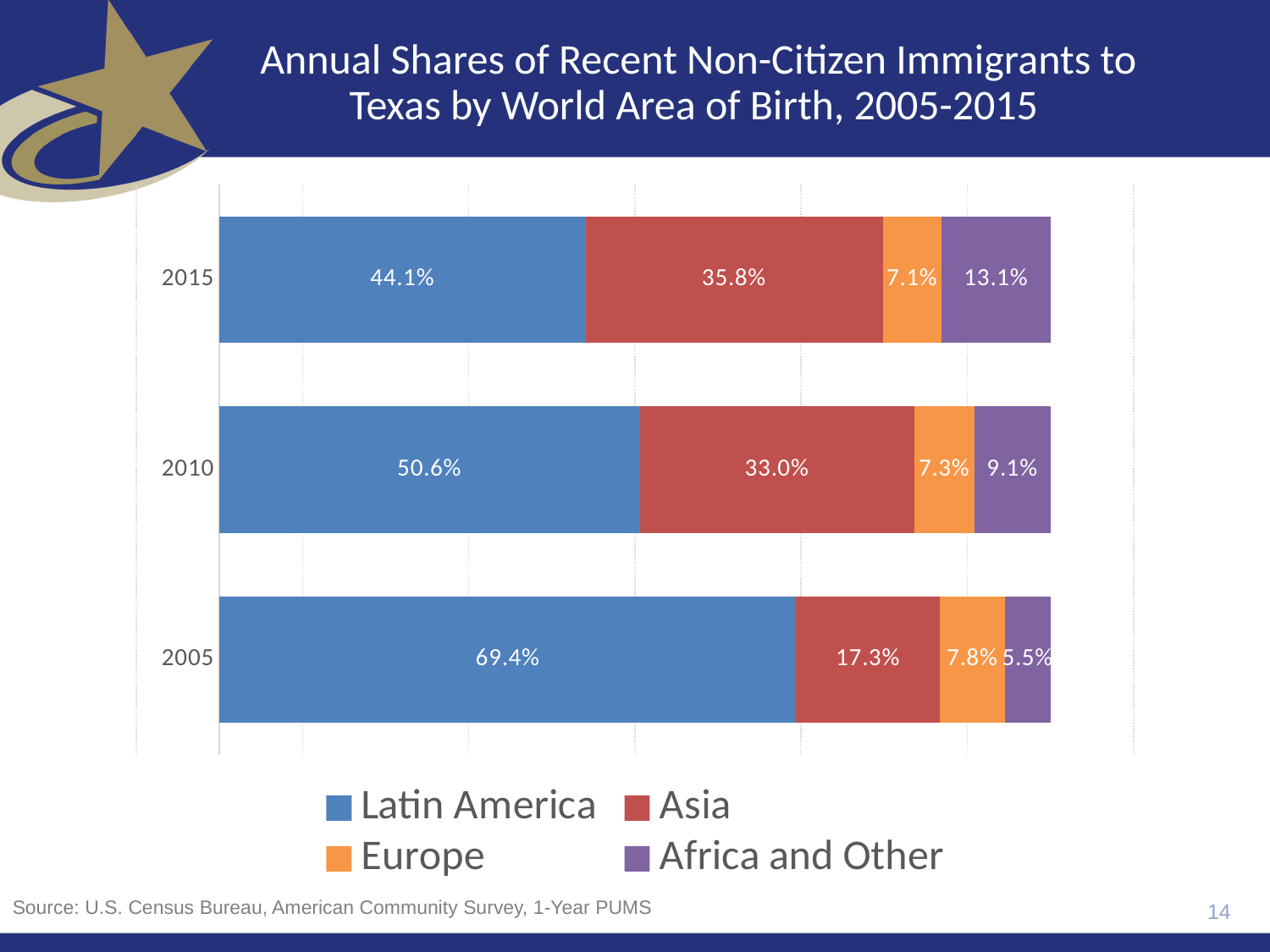
In which year is the Africa and Other share lowest? 2005 How many series does the legend list? 4 How many years are shown on the chart? 3 What is the Latin America share for 2015? 44.1% Which colour represents Asia in the chart? Red What is the Europe share for 2010? 7.3% In which year is the Latin America share highest? 2005 What kind of chart is shown on the slide? Stacked bar chart What is the Asia share for 2005? 17.3% What is the difference between the Latin America share in 2005 and in 2015? 25.3% Which is larger in 2010: the Asia share or the Europe share? Asia What is the Africa and Other share for 2015? 13.1%